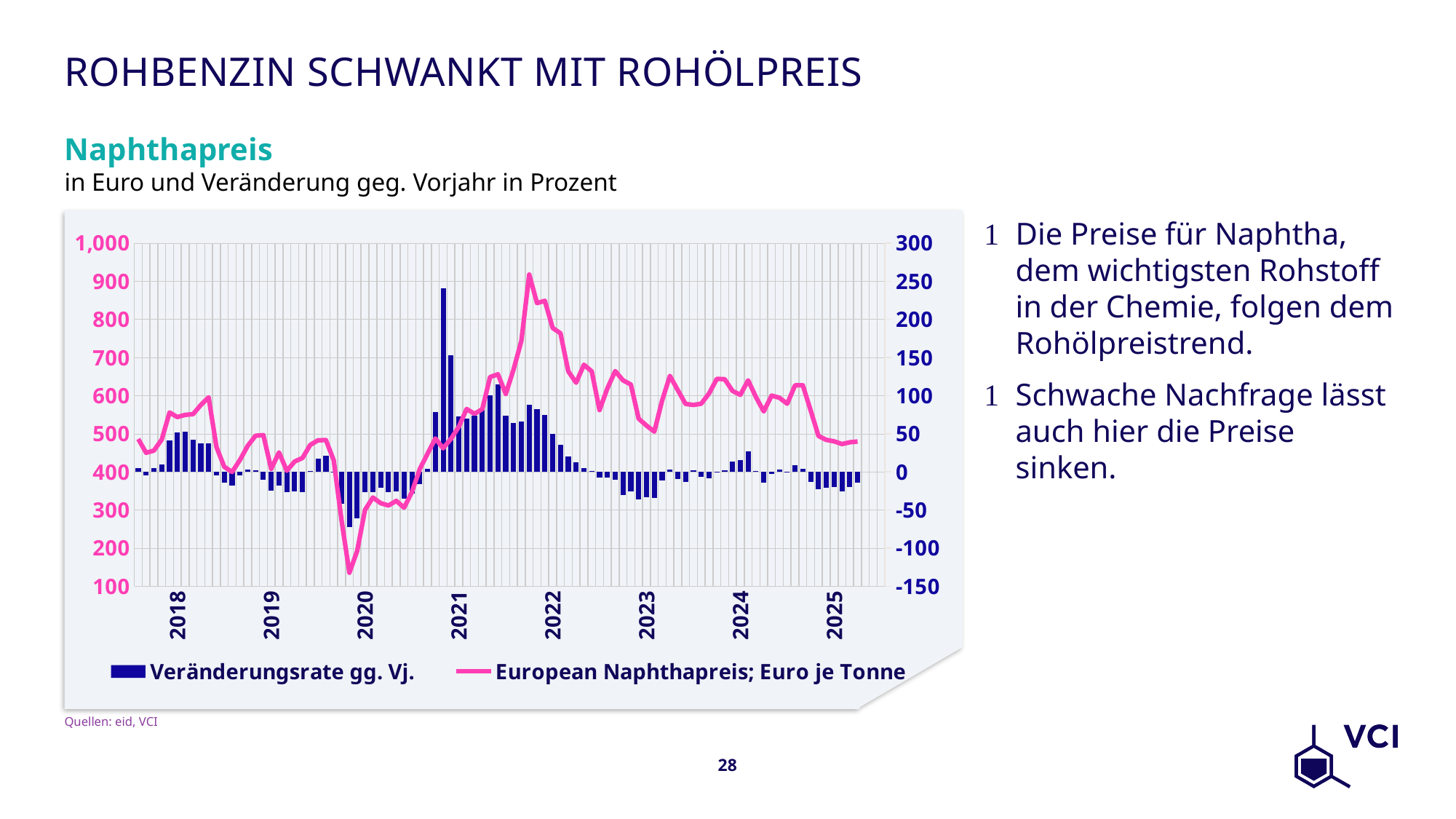
Is the lowest value of the European Naphthapreis line in 2020 greater or less than 200? less In which year does the European Naphthapreis line reach its highest point? 2022 What are the two series named in the chart legend? Veränderungsrate gg. Vj. and European Naphthapreis; Euro je Tonne From its peak in 2022 to 2025, does the European Naphthapreis line generally rise or fall? fall How many series does the chart legend list? 2 What is the title of the chart? Naphthapreis What kind of chart is shown on the slide? A combined bar and line chart Is the European Naphthapreis at the end of the series in 2025 greater or less than 600? less How many year labels are shown on the x axis? 8 Is the peak value of the European Naphthapreis line in 2022 greater or less than 800? greater In which year does the European Naphthapreis line reach its lowest point? 2020